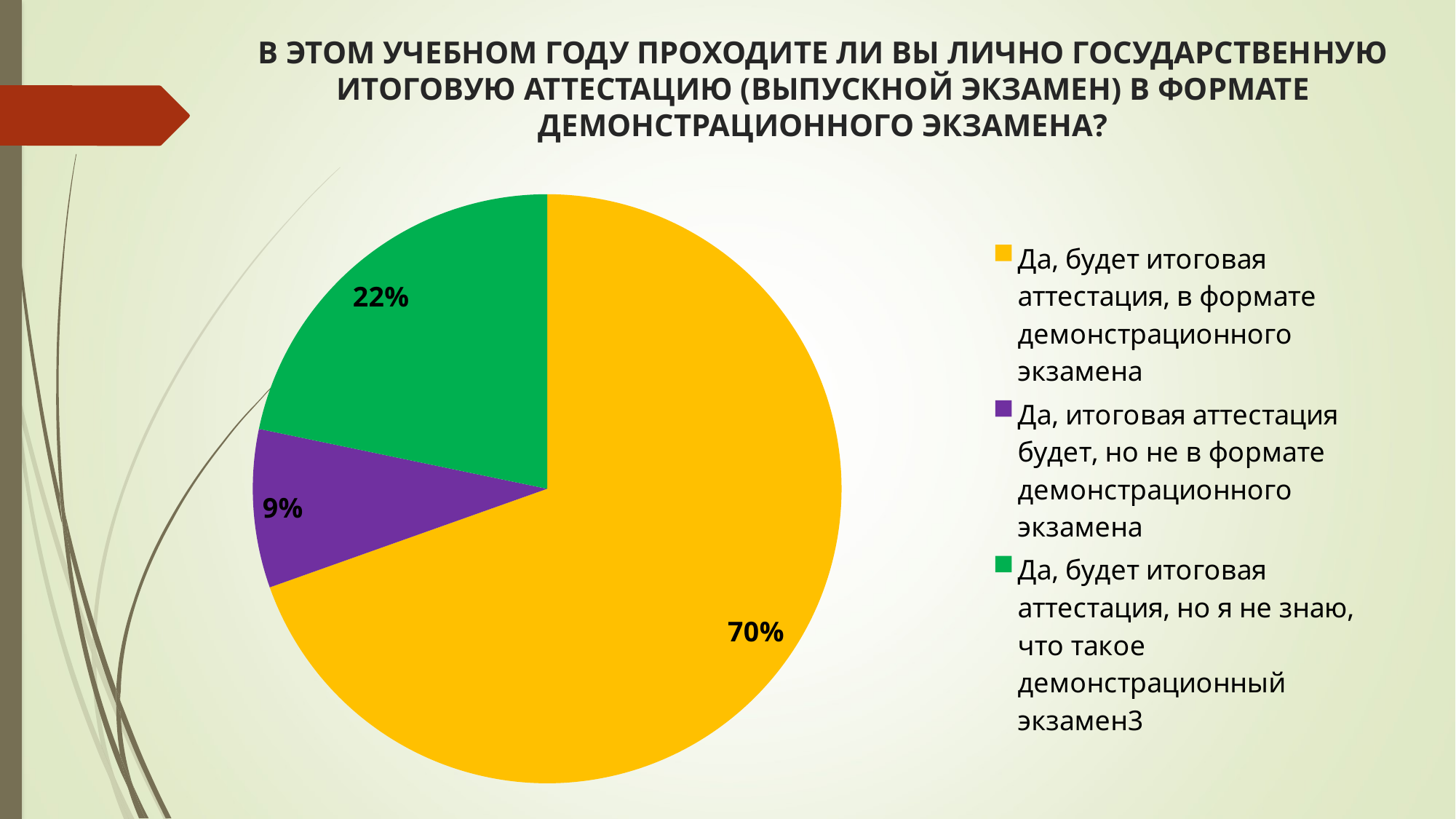
What colour is the slice representing 9%? purple How many entries does the legend list? 3 What share of the pie is labelled "Да, итоговая аттестация будет, но не в формате демонстрационного экзамена"? 9% What is the difference in percentage points between the largest slice (70%) and the slice labelled 22%? 48 What share of the pie is labelled "Да, будет итоговая аттестация, в формате демонстрационного экзамена"? 70% Which is larger: the slice for "Да, будет итоговая аттестация, но я не знаю, что такое демонстрационный экзамен" or the slice for "Да, итоговая аттестация будет, но не в формате демонстрационного экзамена"? Да, будет итоговая аттестация, но я не знаю, что такое демонстрационный экзамен How many slices does the pie chart have? 3 Which category has the largest slice of the pie? Да, будет итоговая аттестация, в формате демонстрационного экзамена What share of the pie is labelled "Да, будет итоговая аттестация, но я не знаю, что такое демонстрационный экзамен"? 22% What kind of chart is shown on the slide? pie chart What colour is the slice representing 70%? yellow Which category has the smallest slice of the pie? Да, итоговая аттестация будет, но не в формате демонстрационного экзамена